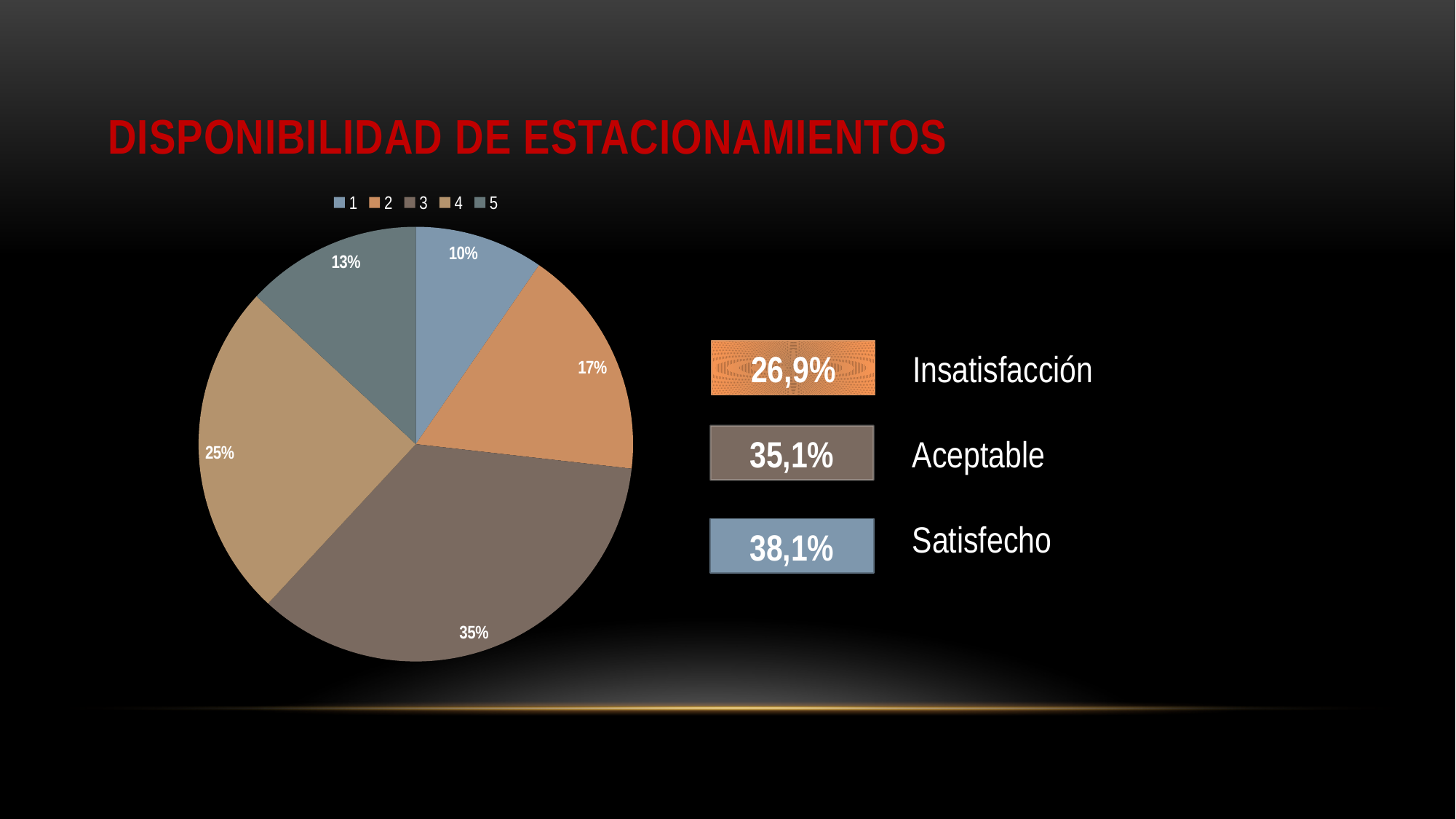
What percentage is shown for category 5 in the pie chart? 13% How many entries does the legend of the pie chart list? 5 What percentage is shown for category 2 in the pie chart? 17% What percentage is shown for category 4 in the pie chart? 25% Which slice is larger in the pie chart, category 2 or category 5? 2 Which category has the largest slice in the pie chart? 3 What percentage is shown for category 1 in the pie chart? 10% How many slices does the pie chart have? 5 What is the difference in percentage points between category 3 and category 1 in the pie chart? 25 What is the title of the chart on the slide? DISPONIBILIDAD DE ESTACIONAMIENTOS What kind of chart is shown on the slide? Pie chart Which category has the smallest slice in the pie chart? 1